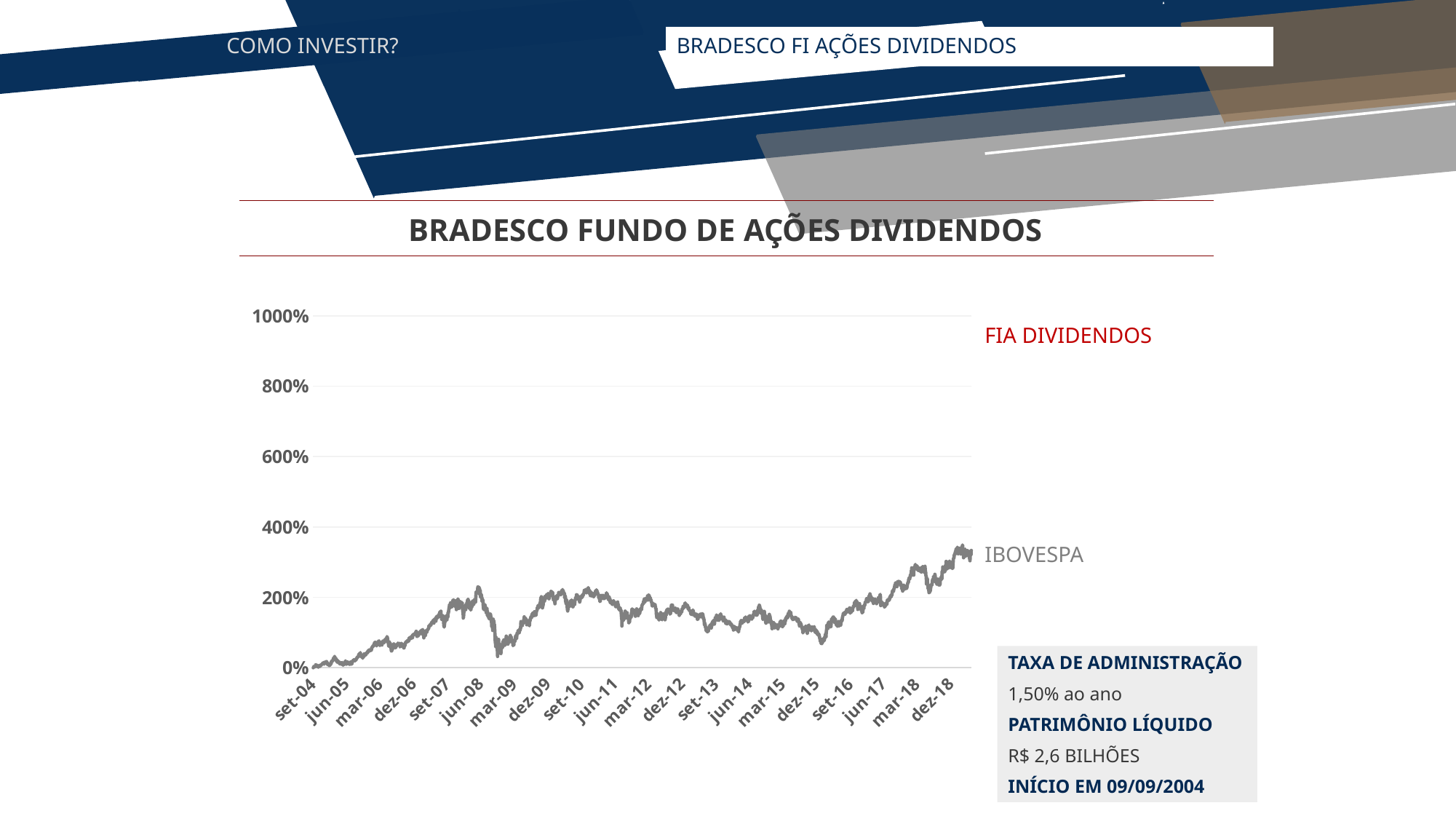
How many series are labelled on the chart? 2 What kind of chart is shown on the slide? line chart How many date labels are shown along the x axis? 20 Does the IBOVESPA line rise or fall between dez-15 and dez-18? rise Is the value of the IBOVESPA line at mar-09 greater or less than 200%? less Is the value of the IBOVESPA line at dez-18 greater or less than 400%? less Is the value of the IBOVESPA line at dez-18 greater or less than 200%? greater What is the title of the chart? BRADESCO FUNDO DE AÇÕES DIVIDENDOS Does the IBOVESPA line rise or fall between jun-08 and mar-09? fall Overall, does the IBOVESPA line rise or fall from set-04 to dez-18? rise What is the value of the IBOVESPA line at set-04? 0% What is the highest value shown on the vertical axis? 1000%